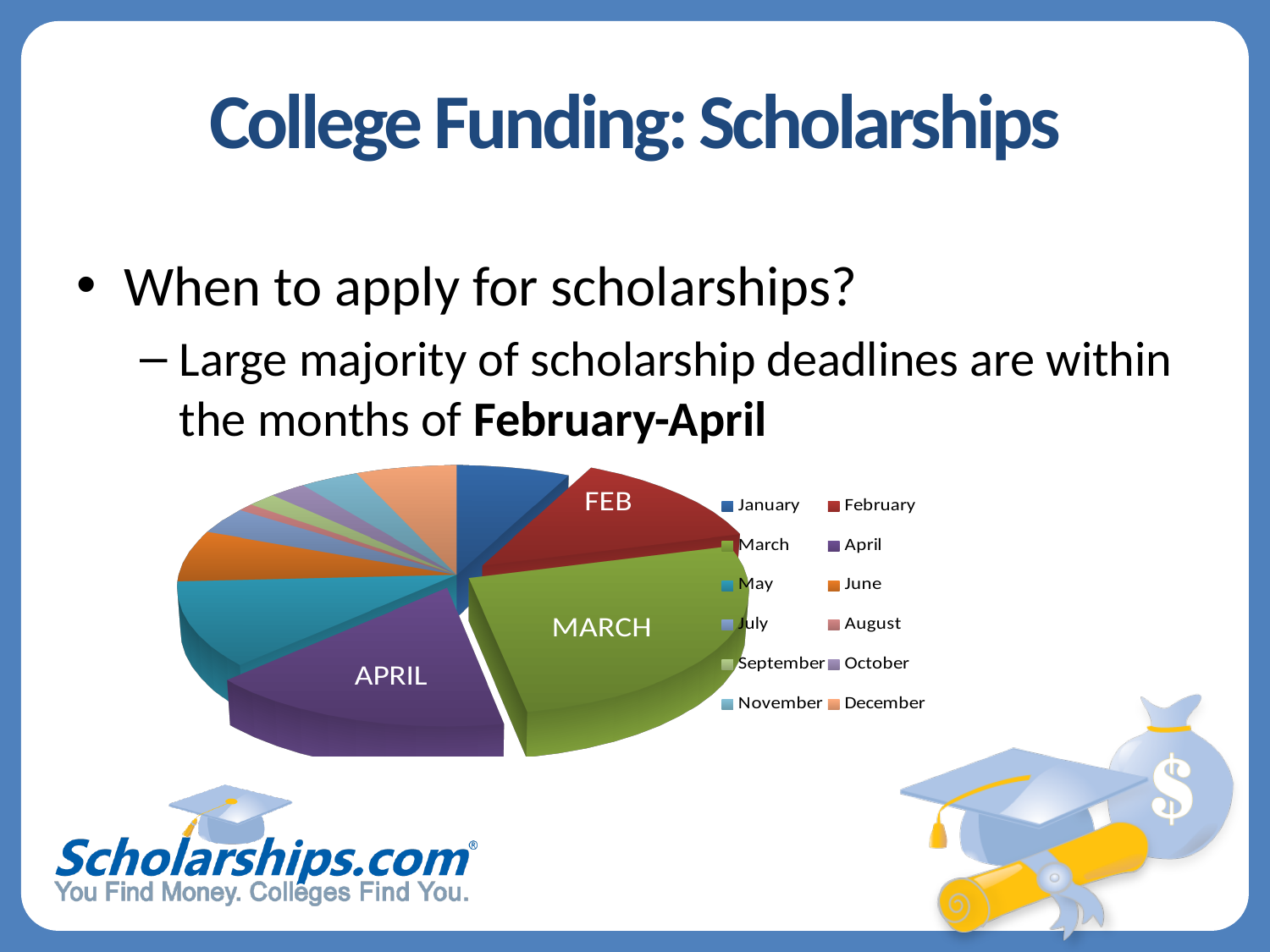
Which three slices are labeled directly on the pie chart? FEB, MARCH, APRIL Which slice is larger in the pie chart, March or February? March Which slice is larger in the pie chart, April or January? April Which slice is larger in the pie chart, March or January? March How many categories (months) does the pie chart's legend list? 12 Which month has the largest slice in the pie chart? March What kind of chart is shown on the slide? pie chart What colour is the March slice in the pie chart? green